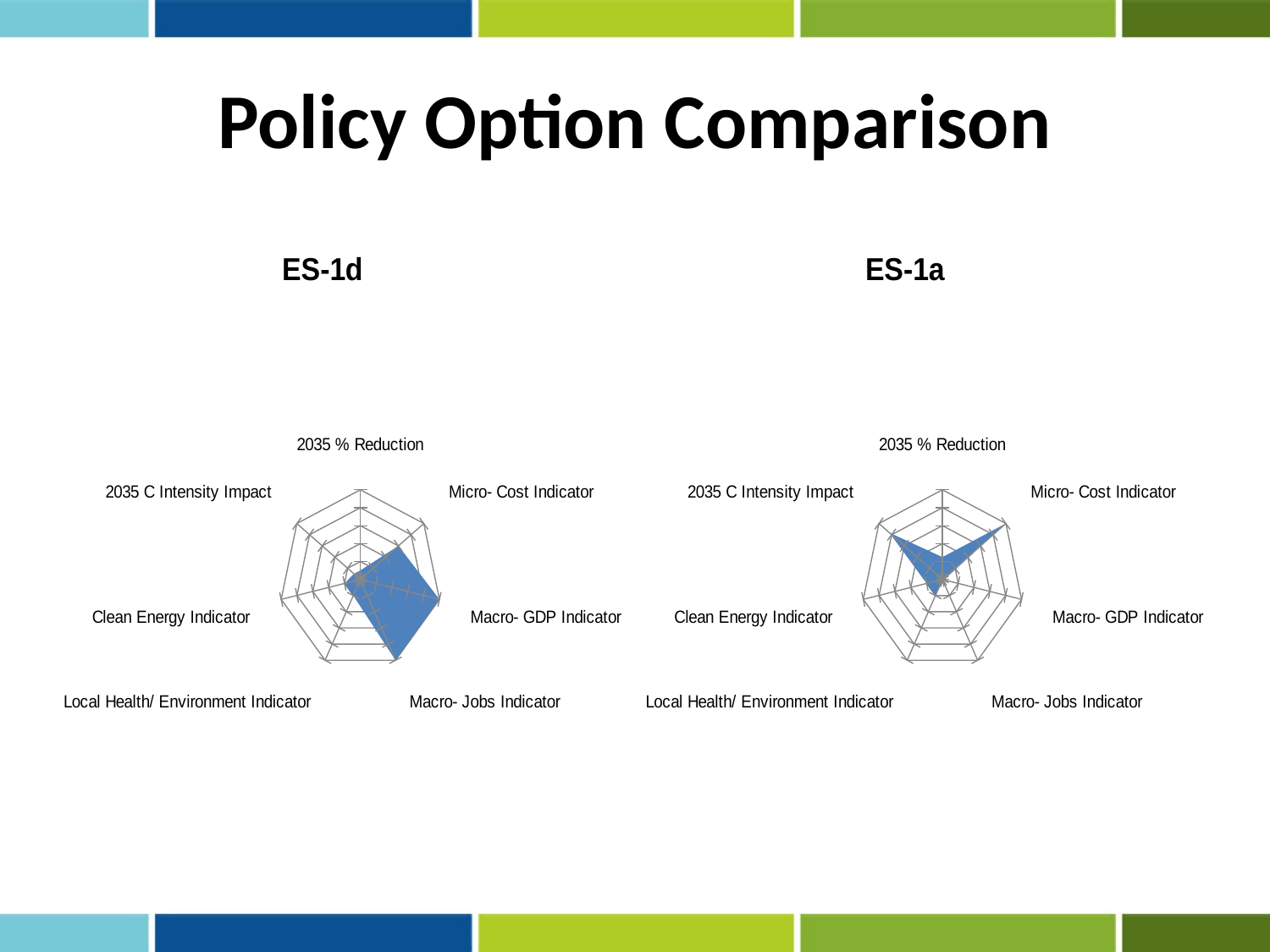
In the ES-1d chart, which is larger: the value for Macro- Jobs Indicator or the value for 2035 C Intensity Impact? Macro- Jobs Indicator What kind of chart is the ES-1d chart? Radar chart What kind of chart is the ES-1a chart? Radar chart In the ES-1d chart, which is larger: the value for Macro- GDP Indicator or the value for Clean Energy Indicator? Macro- GDP Indicator How many indicator axes does the ES-1a radar chart have? 7 How many indicator axes does the ES-1d radar chart have? 7 In the ES-1a chart, which is larger: the value for 2035 C Intensity Impact or the value for Clean Energy Indicator? 2035 C Intensity Impact What is the title of the slide containing the two radar charts? Policy Option Comparison Which axis label appears at the top of both radar charts? 2035 % Reduction